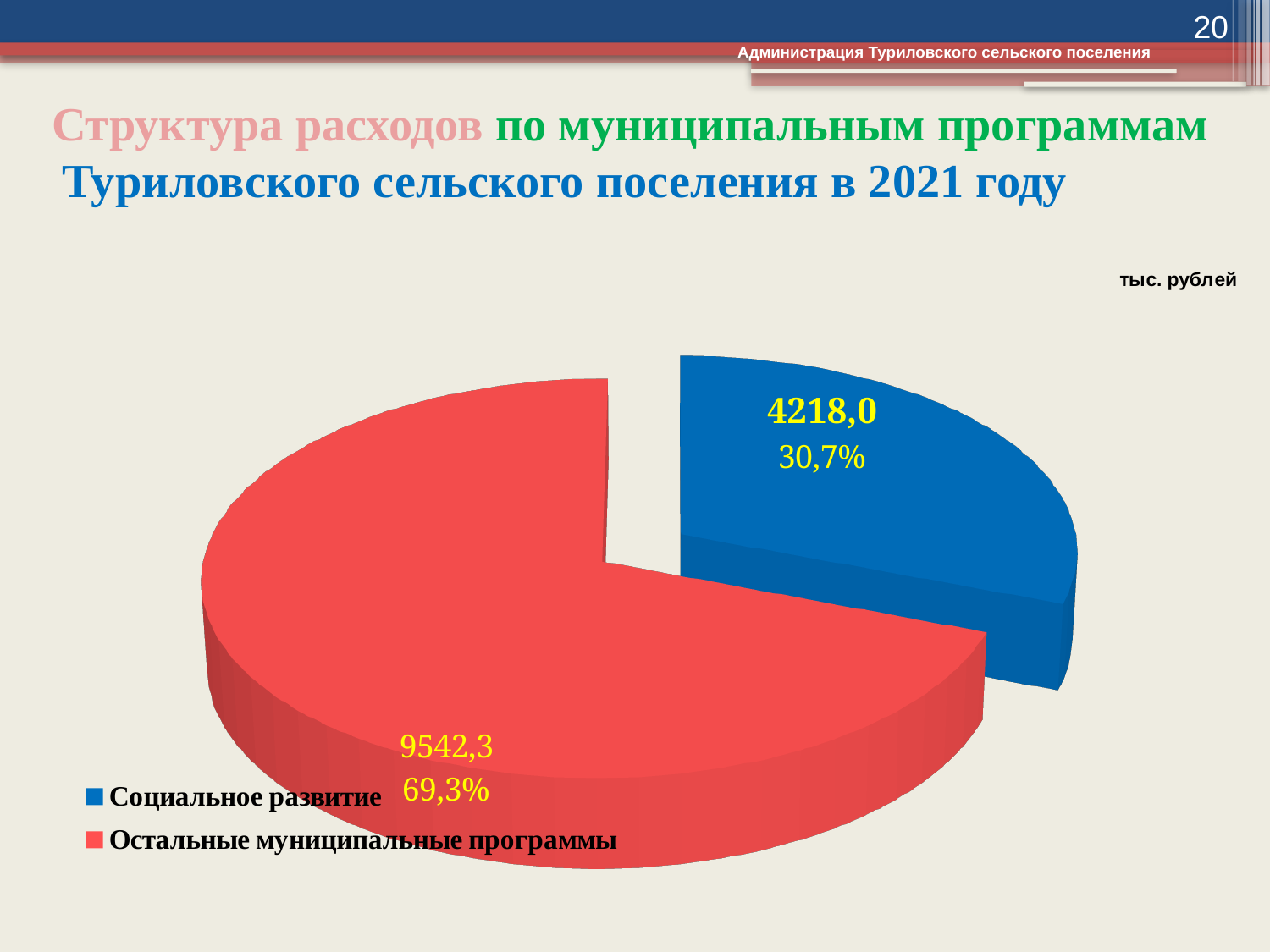
Which category has the smallest slice? Социальное развитие What is the value for Социальное развитие? 4218,0 How many slices does the pie chart have? 2 Which category has the largest slice? Остальные муниципальные программы What colour is the slice for Социальное развитие? blue What is the difference between the values for Остальные муниципальные программы and Социальное развитие? 5324,3 Which is larger: Социальное развитие or Остальные муниципальные программы? Остальные муниципальные программы In what units are the values on the chart given? тыс. рублей What share of the pie does Социальное развитие represent? 30,7% What is the value for Остальные муниципальные программы? 9542,3 What share of the pie does Остальные муниципальные программы represent? 69,3% What kind of chart is shown on the slide? pie chart